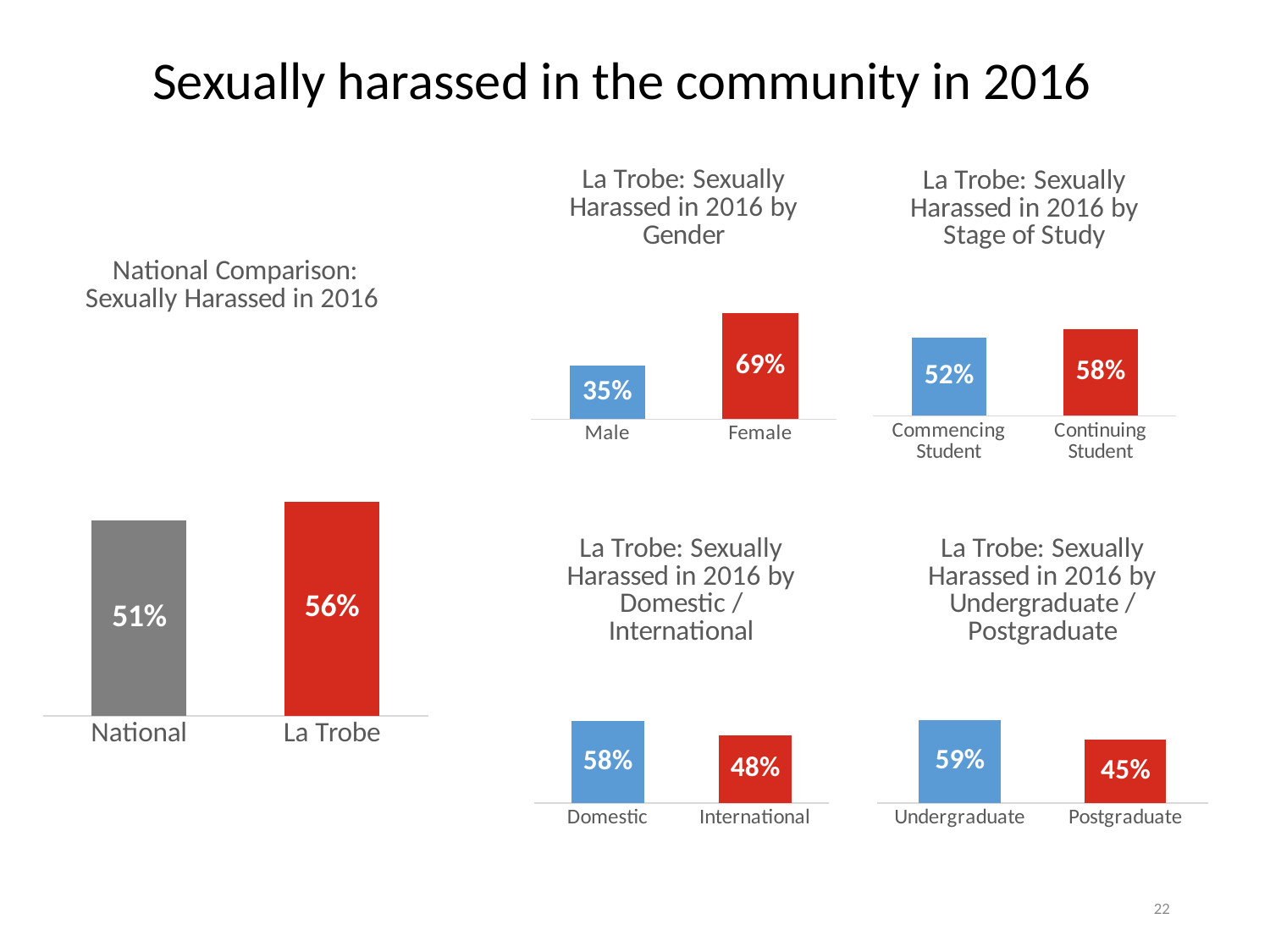
In the 'La Trobe: Sexually Harassed in 2016 by Gender' chart, which category is lowest? Male In the 'National Comparison: Sexually Harassed in 2016' chart, what is the difference between the La Trobe and National values? 5% In the 'La Trobe: Sexually Harassed in 2016 by Undergraduate / Postgraduate' chart, what is the difference between the Undergraduate and Postgraduate values? 14% In the 'La Trobe: Sexually Harassed in 2016 by Stage of Study' chart, what is the value for Commencing Student? 52% In the 'La Trobe: Sexually Harassed in 2016 by Domestic / International' chart, what is the value for International? 48% What kind of chart is the 'La Trobe: Sexually Harassed in 2016 by Undergraduate / Postgraduate' chart? Bar chart In the 'National Comparison: Sexually Harassed in 2016' chart, what is the value for La Trobe? 56% In the 'National Comparison: Sexually Harassed in 2016' chart, what is the value for National? 51% In the 'La Trobe: Sexually Harassed in 2016 by Gender' chart, what is the value for Female? 69% In the 'La Trobe: Sexually Harassed in 2016 by Stage of Study' chart, which is larger, Commencing Student or Continuing Student? Continuing Student In the 'La Trobe: Sexually Harassed in 2016 by Domestic / International' chart, which category is highest? Domestic In the 'La Trobe: Sexually Harassed in 2016 by Gender' chart, what is the difference between the Female and Male values? 34%